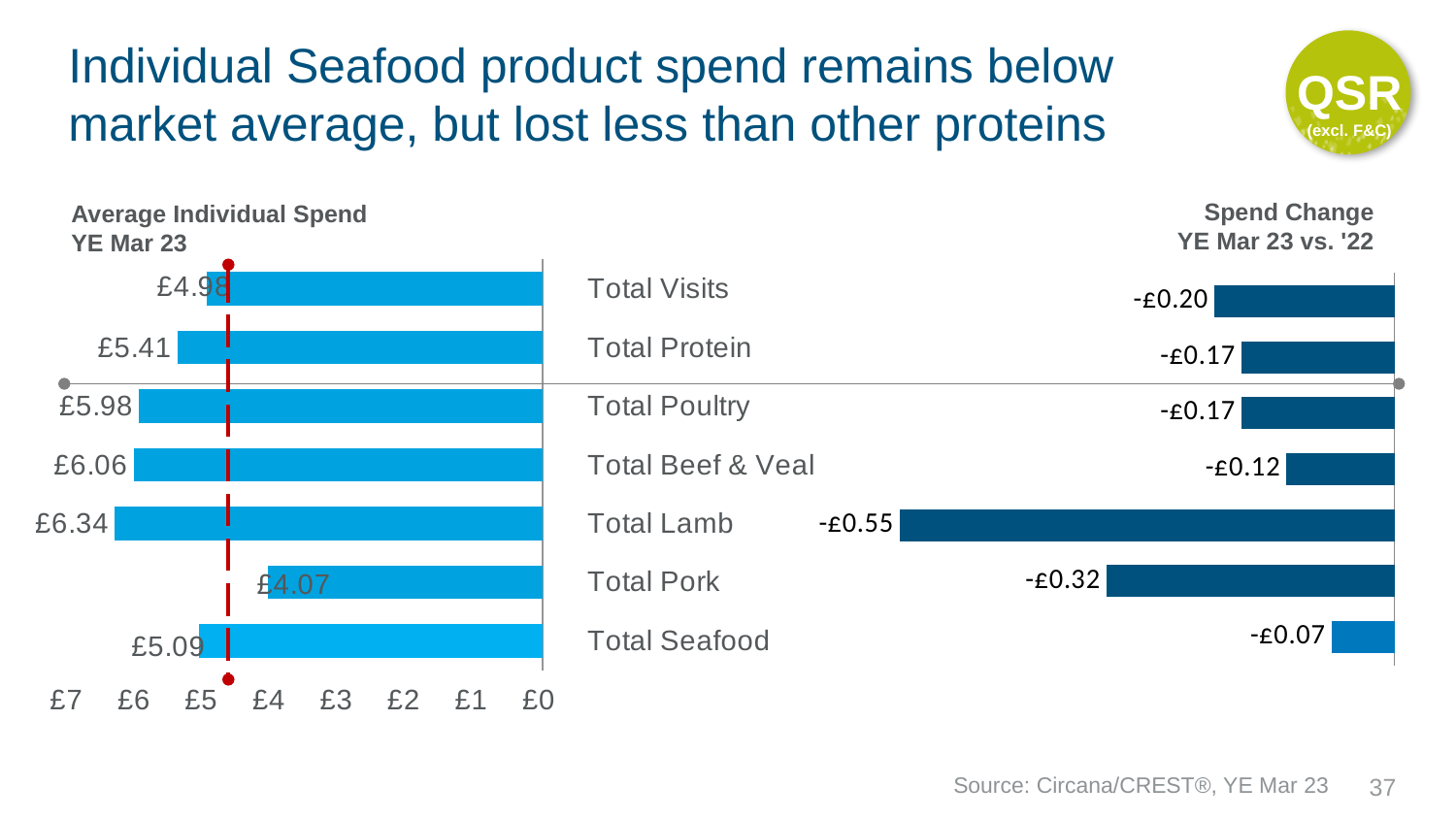
How many categories are shown in the Spend Change YE Mar 23 vs. '22 chart? 7 In the Spend Change YE Mar 23 vs. '22 chart, what is the value for Total Pork? -£0.32 In the Average Individual Spend YE Mar 23 chart, what is the value for Total Seafood? £5.09 In the Average Individual Spend YE Mar 23 chart, what is the value for Total Lamb? £6.34 In the Average Individual Spend YE Mar 23 chart, what is the difference between Total Beef & Veal and Total Seafood? £0.97 What type of chart is the Average Individual Spend YE Mar 23 chart? Bar chart In the Spend Change YE Mar 23 vs. '22 chart, what is the value for Total Seafood? -£0.07 In the Average Individual Spend YE Mar 23 chart, which category has the highest spend? Total Lamb In the Spend Change YE Mar 23 vs. '22 chart, which category shows the largest decline? Total Lamb In the Spend Change YE Mar 23 vs. '22 chart, which is larger in magnitude, the change for Total Visits or Total Beef & Veal? Total Visits In the Average Individual Spend YE Mar 23 chart, is the value for Total Poultry greater or less than £5? greater In the Average Individual Spend YE Mar 23 chart, which category has the lowest spend? Total Pork